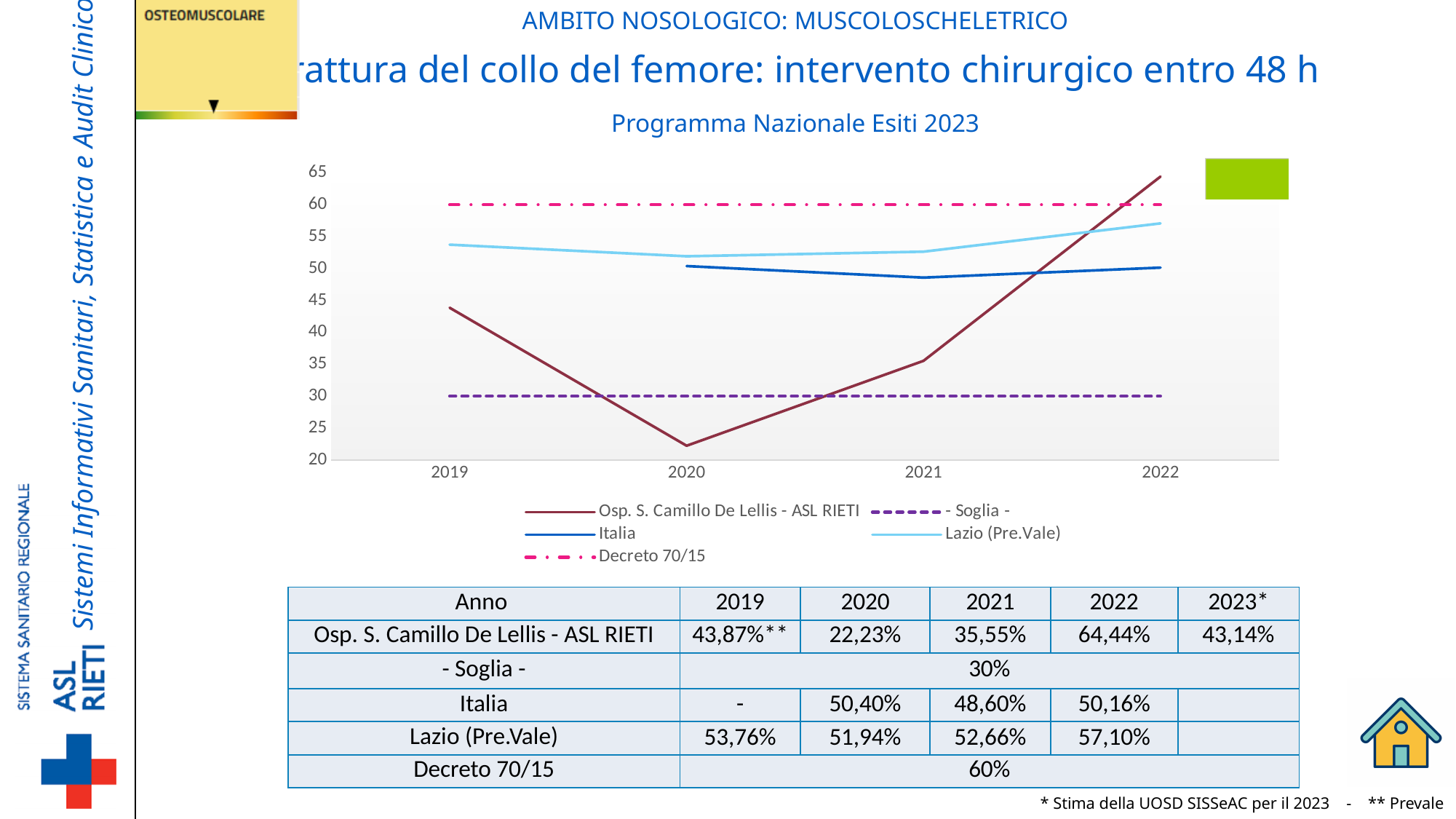
What value does the Soglia line mark? 30% What is the value for Lazio (Pre.Vale) in 2022? 57,10% How many series does the legend list? 5 What type of chart is shown on the slide? line chart Is the value for Osp. S. Camillo De Lellis - ASL RIETI in 2020 greater or less than 30? less Does the Osp. S. Camillo De Lellis - ASL RIETI line rise or fall from 2020 to 2022? rise In which year is the Osp. S. Camillo De Lellis - ASL RIETI value highest? 2022 What is the difference between the Osp. S. Camillo De Lellis - ASL RIETI values for 2022 and 2021? 28,89 percentage points In which year is the Osp. S. Camillo De Lellis - ASL RIETI value lowest? 2020 In 2022, which is larger: Osp. S. Camillo De Lellis - ASL RIETI or Lazio (Pre.Vale)? Osp. S. Camillo De Lellis - ASL RIETI How many years are shown on the x axis of the chart? 4 What is the value for Osp. S. Camillo De Lellis - ASL RIETI in 2020? 22,23%